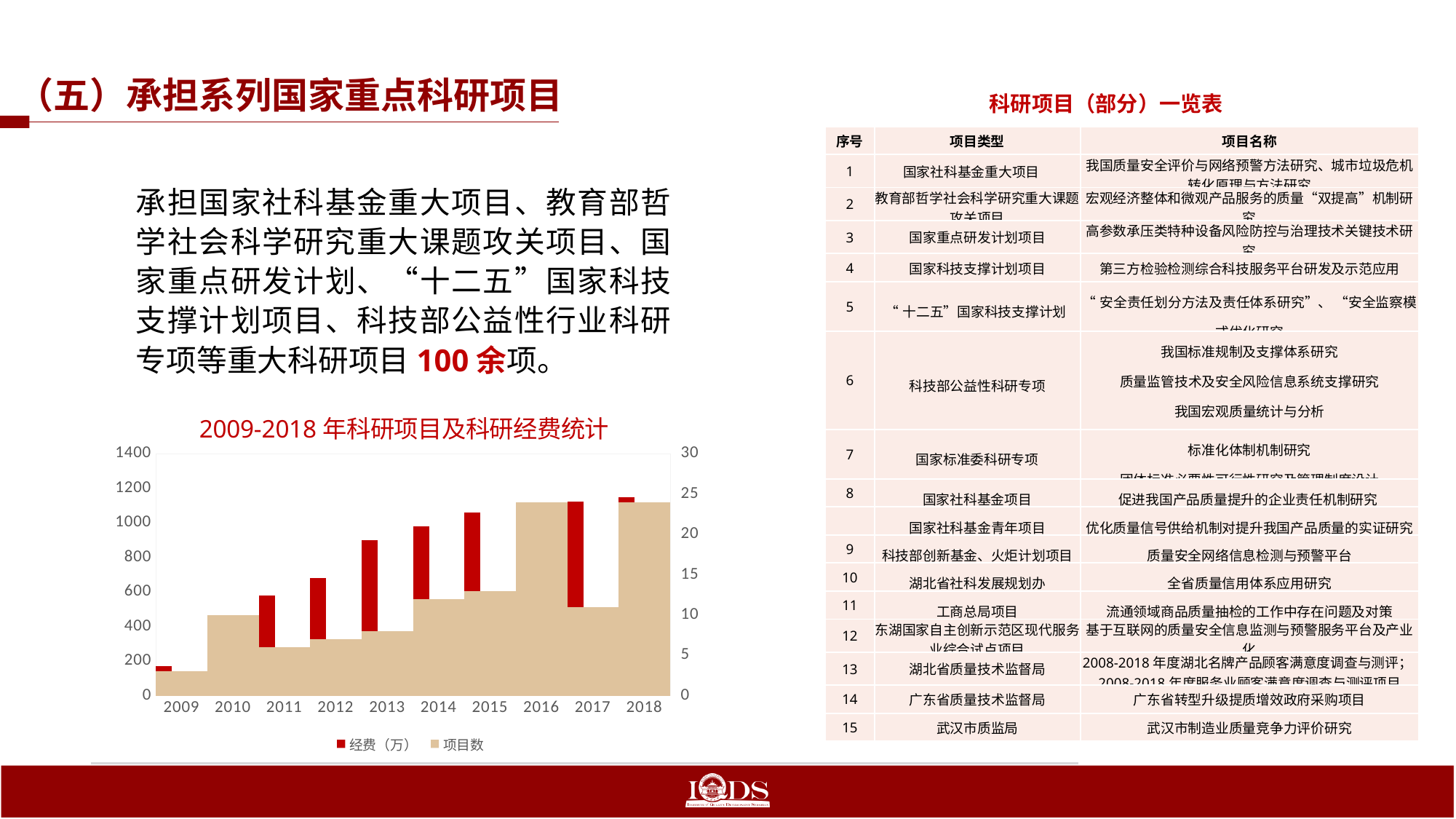
Is the 经费（万） value for 2009 greater or less than 200? less Is the 项目数 value for 2016 greater or less than 20? greater Is the 经费（万） value for 2013 greater or less than 800? greater Which year has the larger 经费（万） value, 2011 or 2013? 2013 What kind of chart is shown on the slide? bar chart What are the two series named in the chart legend? 经费（万） and 项目数 What is the title of the chart on the slide? 2009-2018 年科研项目及科研经费统计 How many years are shown on the x axis of the chart? 10 Does the 经费（万） series generally rise or fall from 2009 to 2018? rise How many series does the chart legend list? 2